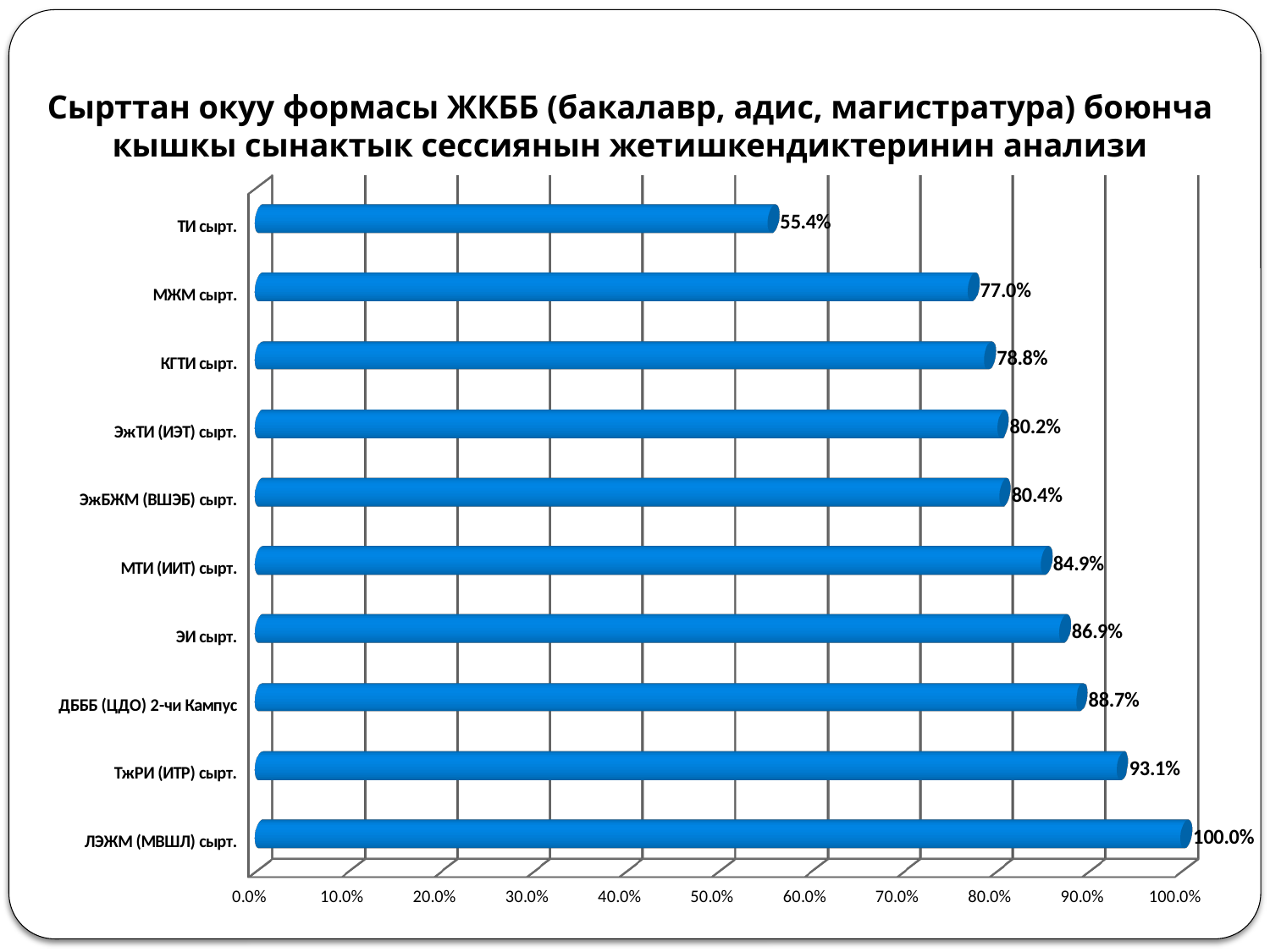
What is the value for ТИ сырт.? 55.4% How many categories are shown in the chart? 10 What is the difference between the values for ТжРИ (ИТР) сырт. and МЖМ сырт.? 16.1% Which category has the lowest value? ТИ сырт. What is the value for ЭжБЖМ (ВШЭБ) сырт.? 80.4% Is the value for ЭжТИ (ИЭТ) сырт. greater or less than 70.0%? greater What colour are the bars in the chart? blue What kind of chart is shown on the slide? bar chart What is the value for ДБББ (ЦДО) 2-чи Кампус? 88.7% Which is larger, the value for ЭИ сырт. or the value for КГТИ сырт.? ЭИ сырт. Which category has the highest value? ЛЭЖМ (МВШЛ) сырт. What is the value for МТИ (ИИТ) сырт.? 84.9%